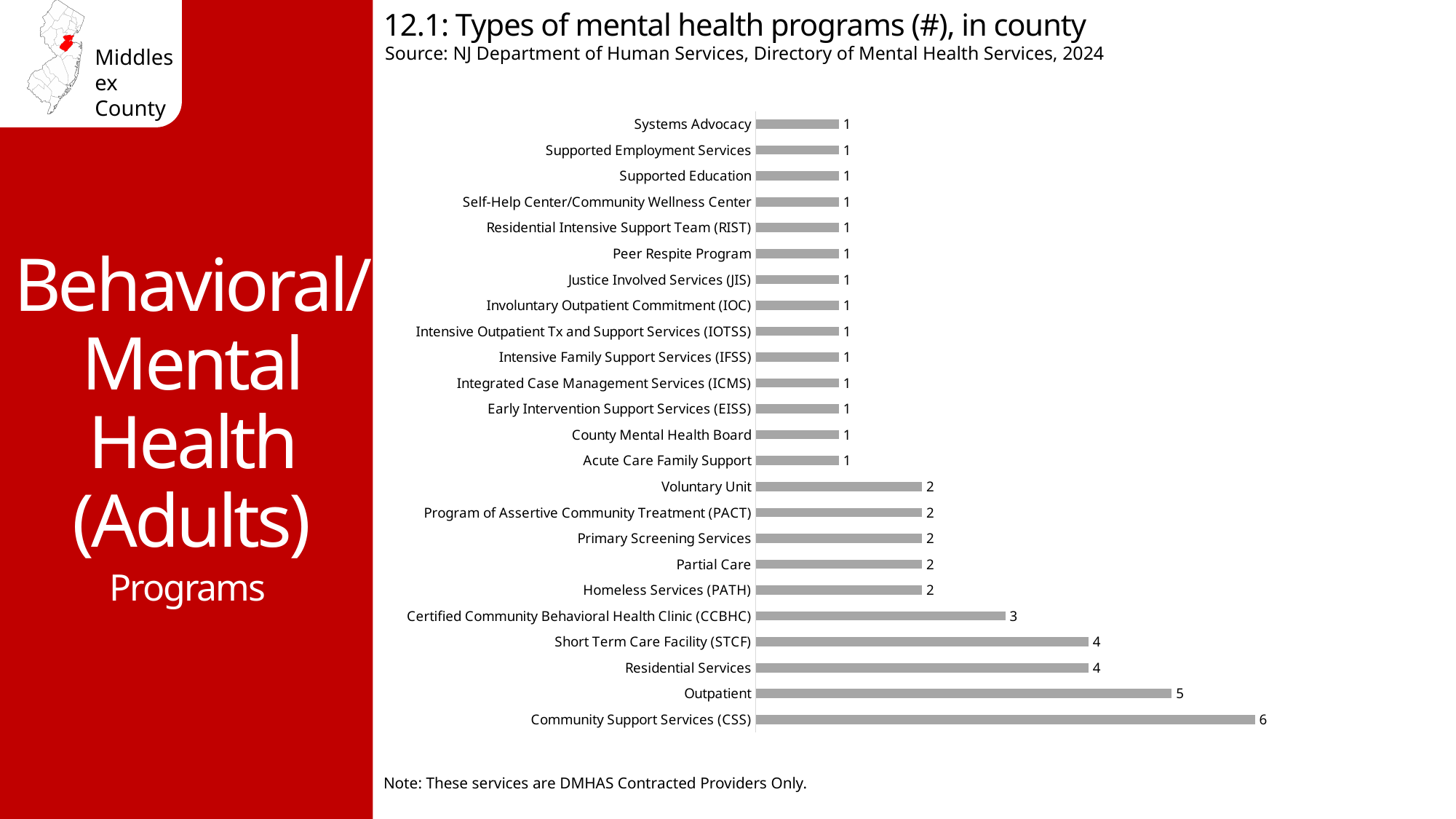
What is the value for Outpatient? 5 What is the difference between the values for Short Term Care Facility (STCF) and Homeless Services (PATH)? 2 What is the value for Partial Care? 2 How many categories are shown in the chart? 24 What is the title of the chart? 12.1: Types of mental health programs (#), in county Which category has the highest value? Community Support Services (CSS) What is the difference between the values for Community Support Services (CSS) and Outpatient? 1 What is the value for Peer Respite Program? 1 Which is larger, the value for Residential Services or the value for Voluntary Unit? Residential Services What kind of chart is shown on the slide? Bar chart What is the value for Community Support Services (CSS)? 6 What is the value for Certified Community Behavioral Health Clinic (CCBHC)? 3